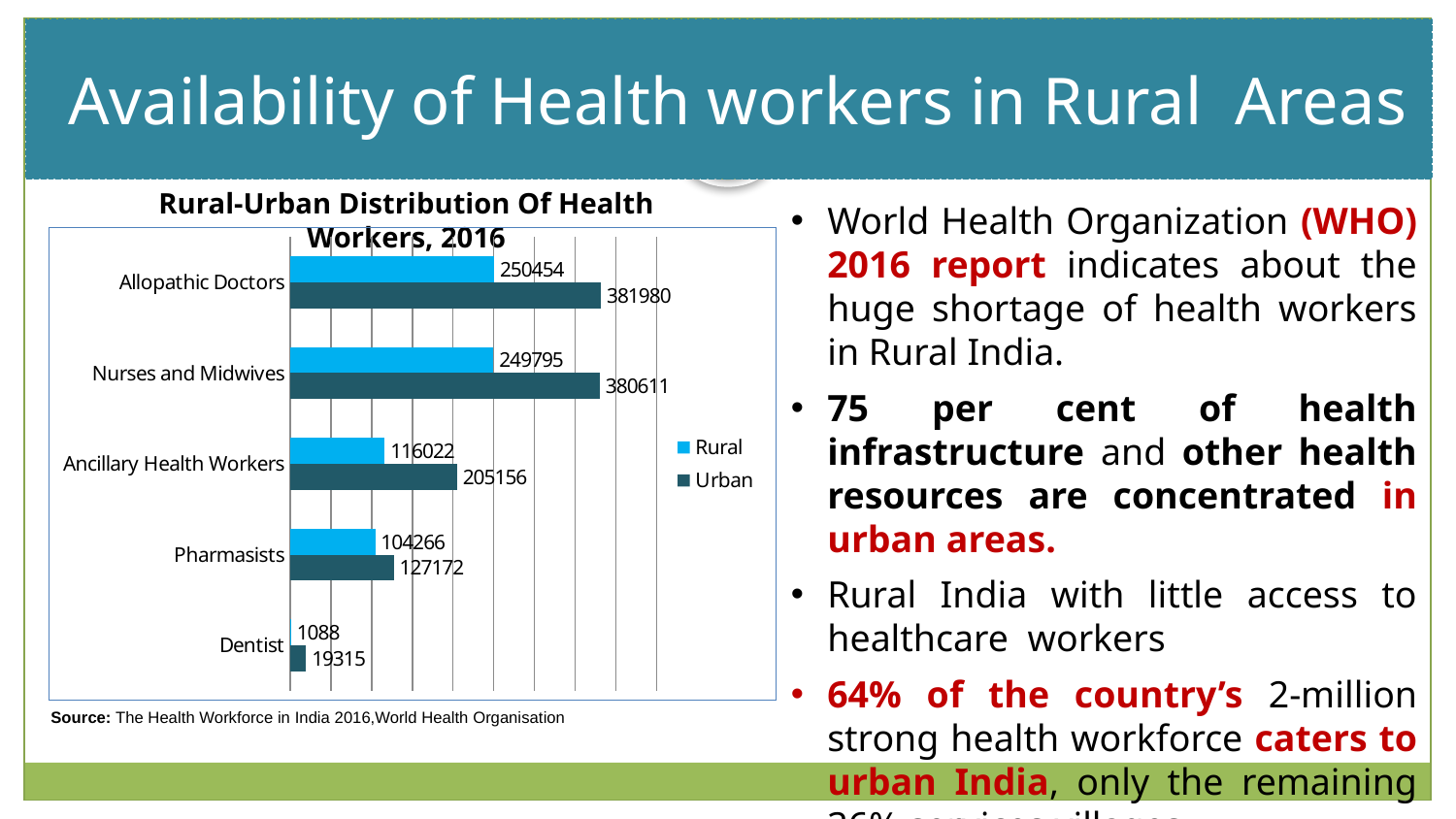
What is the Rural value for Dentist? 1088 How many categories are shown on the chart? 5 How many series does the legend list? 2 Which is larger for Dentist, the Rural value or the Urban value? Urban What is the Rural value for Nurses and Midwives? 249795 Which category has the lowest Rural value? Dentist What is the Urban value for Pharmasists? 127172 What is the difference between the Urban and Rural values for Ancillary Health Workers? 89134 Which category has the highest Urban value? Allopathic Doctors What kind of chart is shown on the slide? Bar chart What is the title of the chart? Rural-Urban Distribution Of Health Workers, 2016 What is the Urban value for Allopathic Doctors? 381980